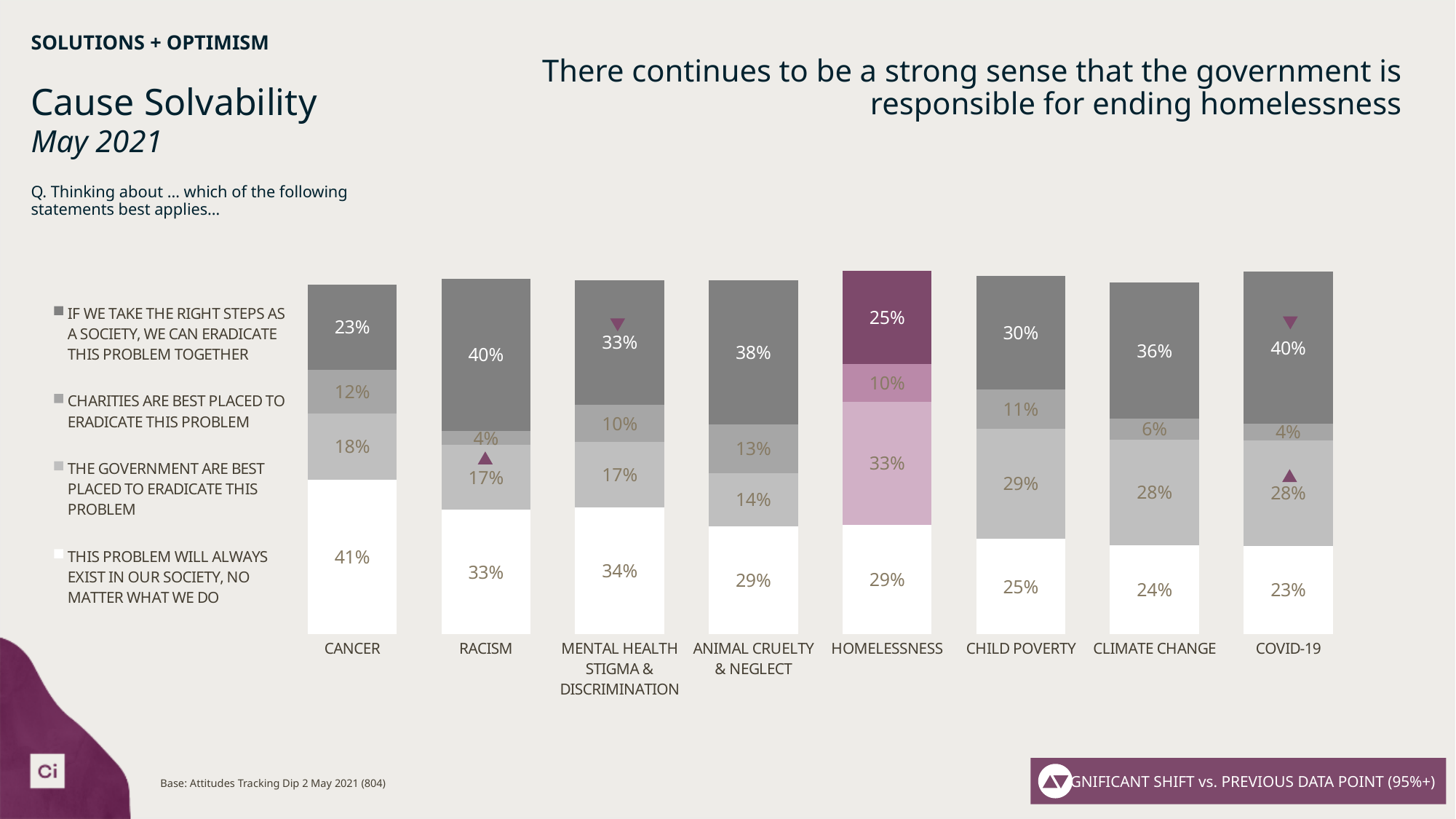
Which cause has the lowest share saying the problem will always exist in our society? COVID-19 What is the difference between the 'if we take the right steps as a society' share for racism and for cancer? 17 percentage points What percentage say charities are best placed to eradicate climate change? 6% How many series does the legend list? 4 Which cause's bar is highlighted in purple rather than grey? Homelessness How many causes (categories) are shown along the x axis of the chart? 8 Which has a larger share saying the government are best placed to eradicate the problem: homelessness or child poverty? Homelessness Which cause has the highest share saying the problem will always exist in our society? Cancer What is the total of the four labelled segments in the homelessness bar? 97% What percentage say cancer will always exist in our society, no matter what we do? 41% What kind of chart is shown on the slide? Stacked bar chart What percentage say the government are best placed to eradicate homelessness? 33%